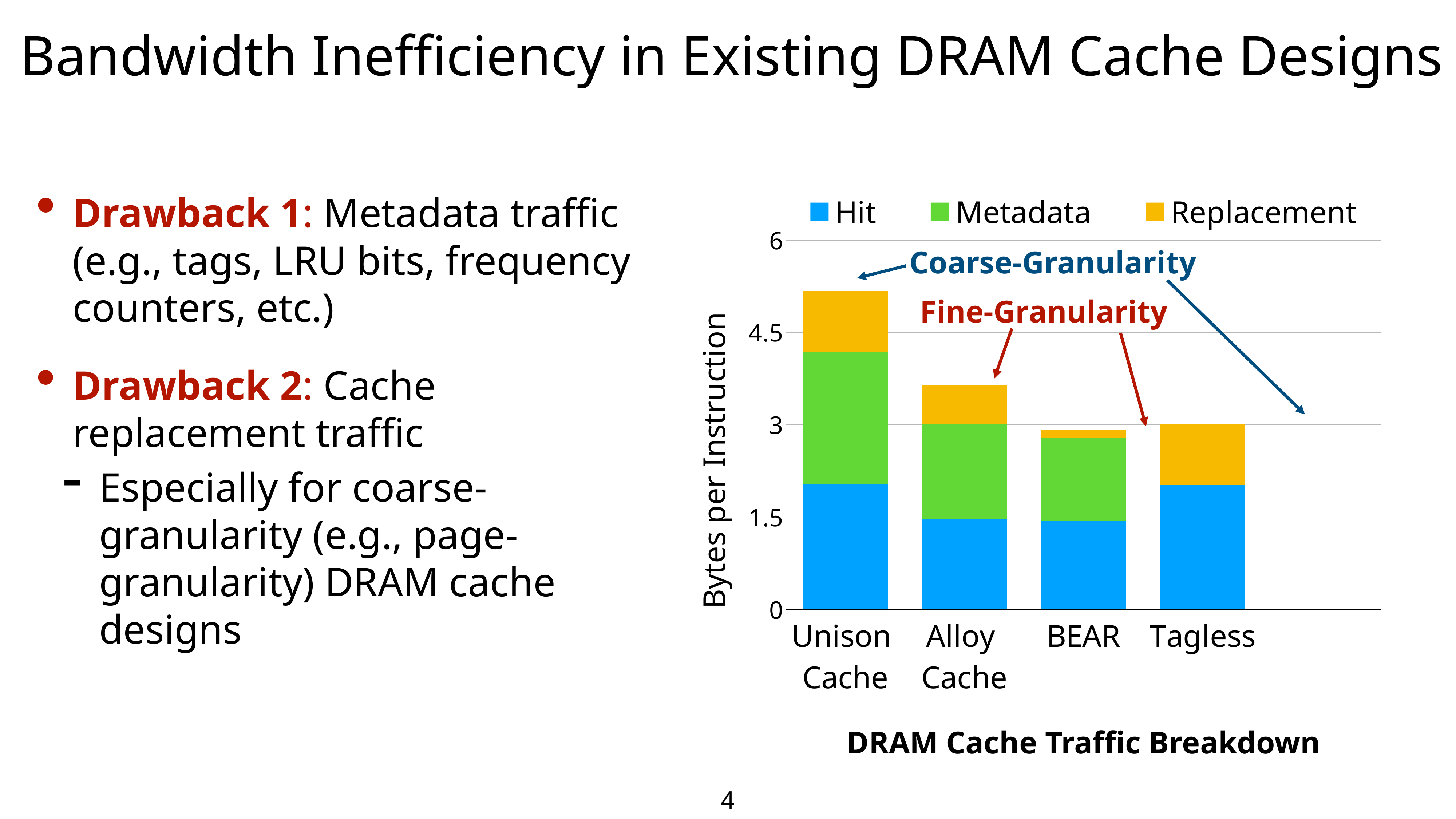
Which has a larger total bytes per instruction, Unison Cache or Alloy Cache? Unison Cache Is the Hit traffic for Unison Cache greater or less than 1.5 bytes per instruction? greater Is the total bytes per instruction for Unison Cache greater or less than 4.5? greater How many series does the chart legend list? 3 Which DRAM cache design has the highest total bytes per instruction? Unison Cache Is the total bytes per instruction for Alloy Cache greater or less than 3? greater What kind of chart is shown on the slide? Stacked bar chart Which has a larger total bytes per instruction, Alloy Cache or BEAR? Alloy Cache What is the title of the chart? DRAM Cache Traffic Breakdown How many DRAM cache designs are shown on the x axis of the chart? 4 What is the label on the y axis of the chart? Bytes per Instruction